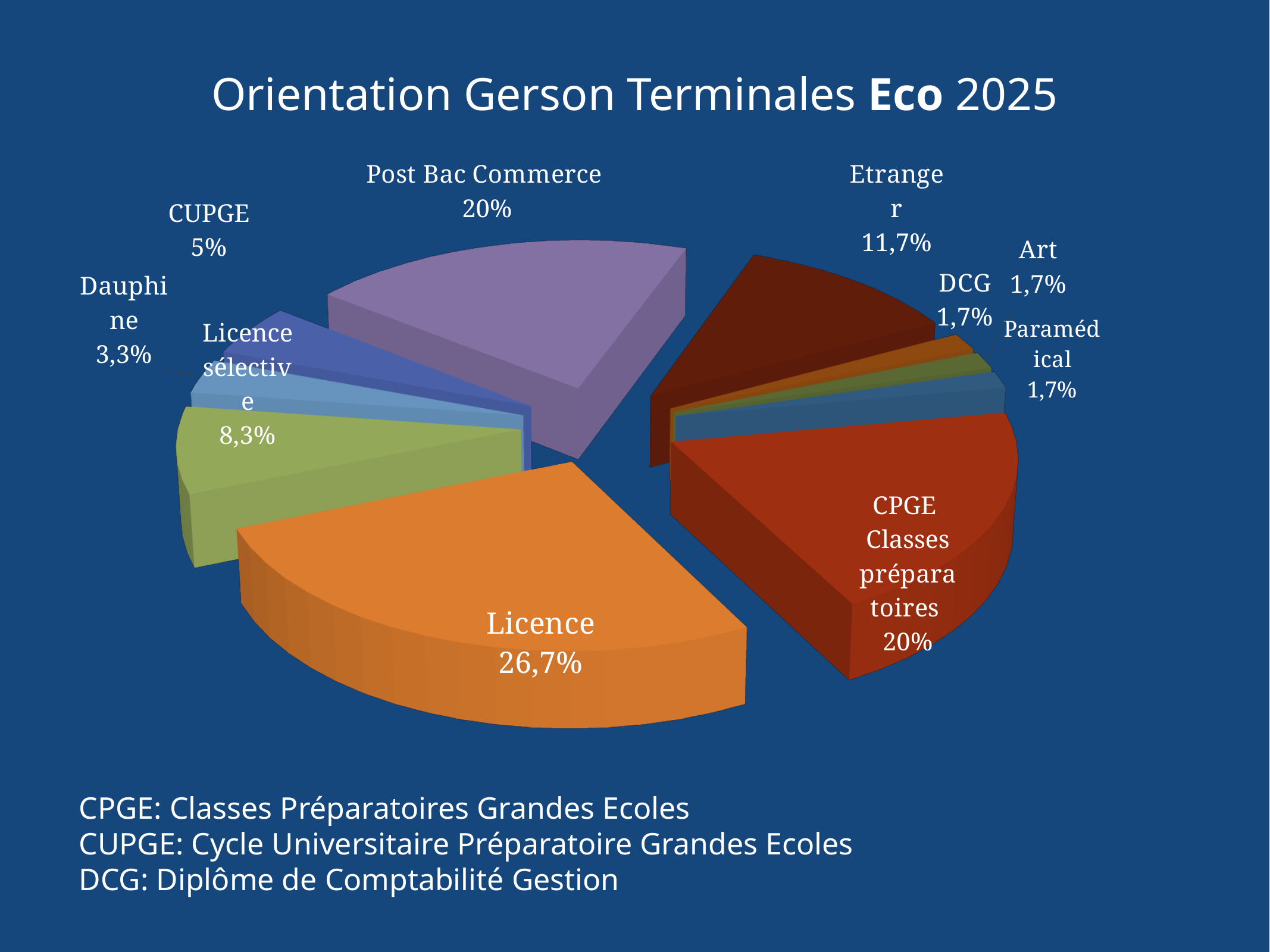
What is the difference between the shares of Licence and CPGE Classes préparatoires? 6,7% What is the combined share of Post Bac Commerce and CPGE Classes préparatoires? 40% Which category has the largest share of the pie? Licence What percentage is shown for Post Bac Commerce? 20% What percentage is shown for Dauphine? 3,3% What kind of chart is shown on the slide? Pie chart How many categories (slices) does the pie chart have? 10 What share of the pie does Licence represent? 26,7% What percentage is shown for Etranger? 11,7% What percentage is shown for Licence sélective? 8,3% What is the title of the chart? Orientation Gerson Terminales Eco 2025 Which is larger, the share for Etranger or the share for CUPGE? Etranger